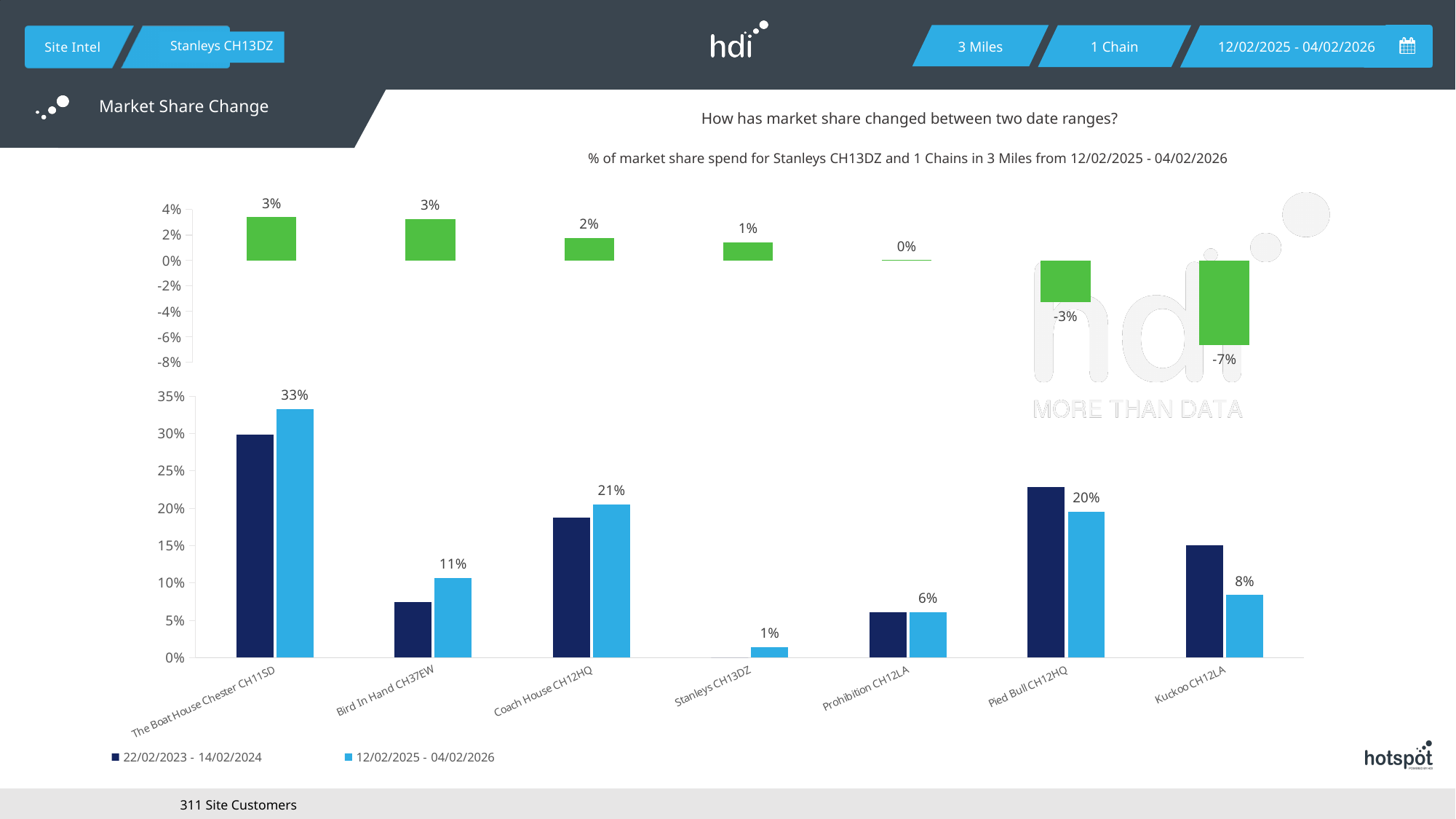
In the bottom chart, what is the market share for Pied Bull CH12HQ in the 12/02/2025 - 04/02/2026 period? 20% In the top chart, what is the market share change shown for Pied Bull CH12HQ? -3% In the bottom chart, which category has the highest market share in the 12/02/2025 - 04/02/2026 period? The Boat House Chester CH11SD In the bottom chart, what is the market share for The Boat House Chester CH11SD in the 12/02/2025 - 04/02/2026 period? 33% In the top chart, what is the market share change shown for Kuckoo CH12LA? -7% In the bottom chart, which is larger for the 12/02/2025 - 04/02/2026 period: Prohibition CH12LA or Kuckoo CH12LA? Kuckoo CH12LA How many series does the legend of the bottom chart list? 2 In the top chart, which category has the lowest market share change? Kuckoo CH12LA In the bottom chart, is the 22/02/2023 - 14/02/2024 value for The Boat House Chester CH11SD greater or less than 25%? greater In the bottom chart, what is the difference between the 12/02/2025 - 04/02/2026 market share of Coach House CH12HQ and Bird In Hand CH37EW? 10% How many categories are shown on the x axis of the bottom chart? 7 What type of chart is the bottom chart? Bar chart